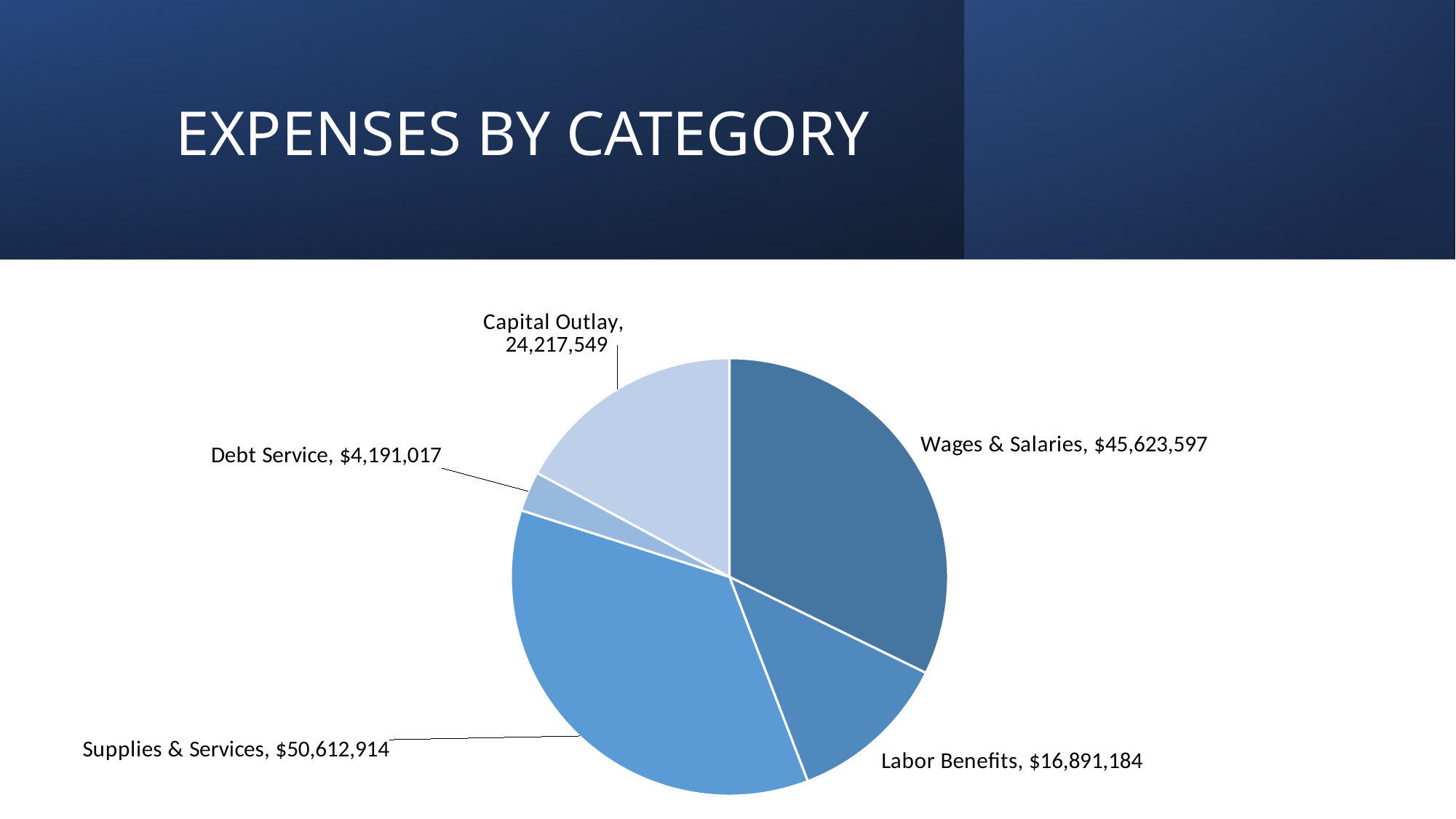
What is the value for Debt Service? $4,191,017 Which category has the largest expense? Supplies & Services What is the value for Labor Benefits? $16,891,184 Which category has the smallest expense? Debt Service How many categories are shown in the pie chart? 5 What is the value for Capital Outlay? 24,217,549 Which is larger, Wages & Salaries or Labor Benefits? Wages & Salaries What is the title of the chart on the slide? EXPENSES BY CATEGORY What is the difference between Supplies & Services and Wages & Salaries? $4,989,317 What kind of chart is shown on the slide? Pie chart What is the difference between Capital Outlay and Debt Service? 20,026,532 What is the value for Wages & Salaries? $45,623,597